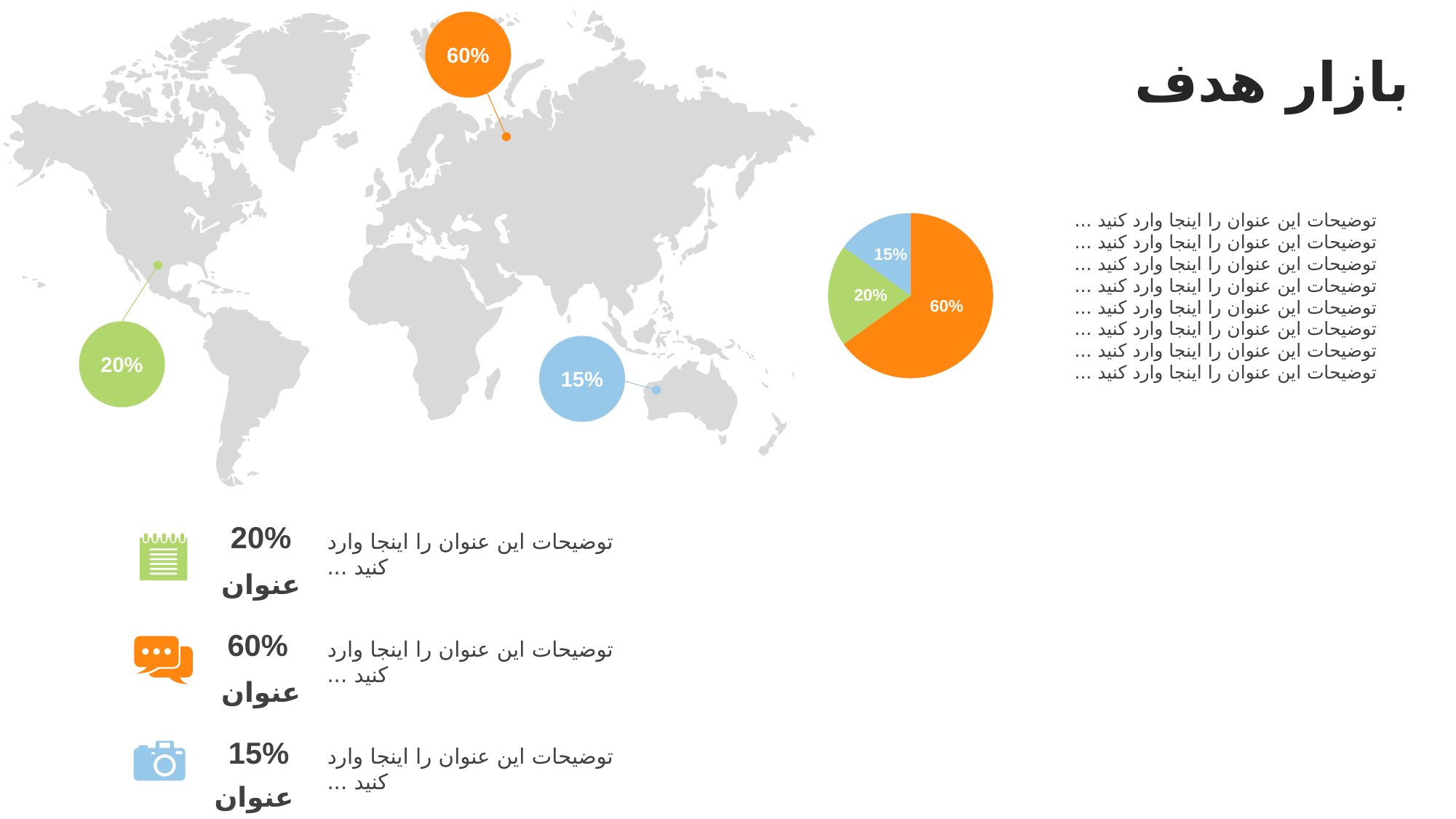
What is the difference between the orange slice and the green slice in the pie chart? 40% What is the combined value of the green and blue slices in the pie chart? 35% Which slice of the pie chart is the smallest? the blue slice (15%) Which slice of the pie chart is the largest? the orange slice (60%) How many slices does the pie chart have? 3 What value is shown on the green slice of the pie chart? 20% What colour is the largest slice of the pie chart? orange What is the difference between the green slice and the blue slice in the pie chart? 5% What value is shown on the orange slice of the pie chart? 60% Which is larger in the pie chart, the green slice or the blue slice? the green slice What value is shown on the blue slice of the pie chart? 15% What kind of chart is shown on the slide? pie chart